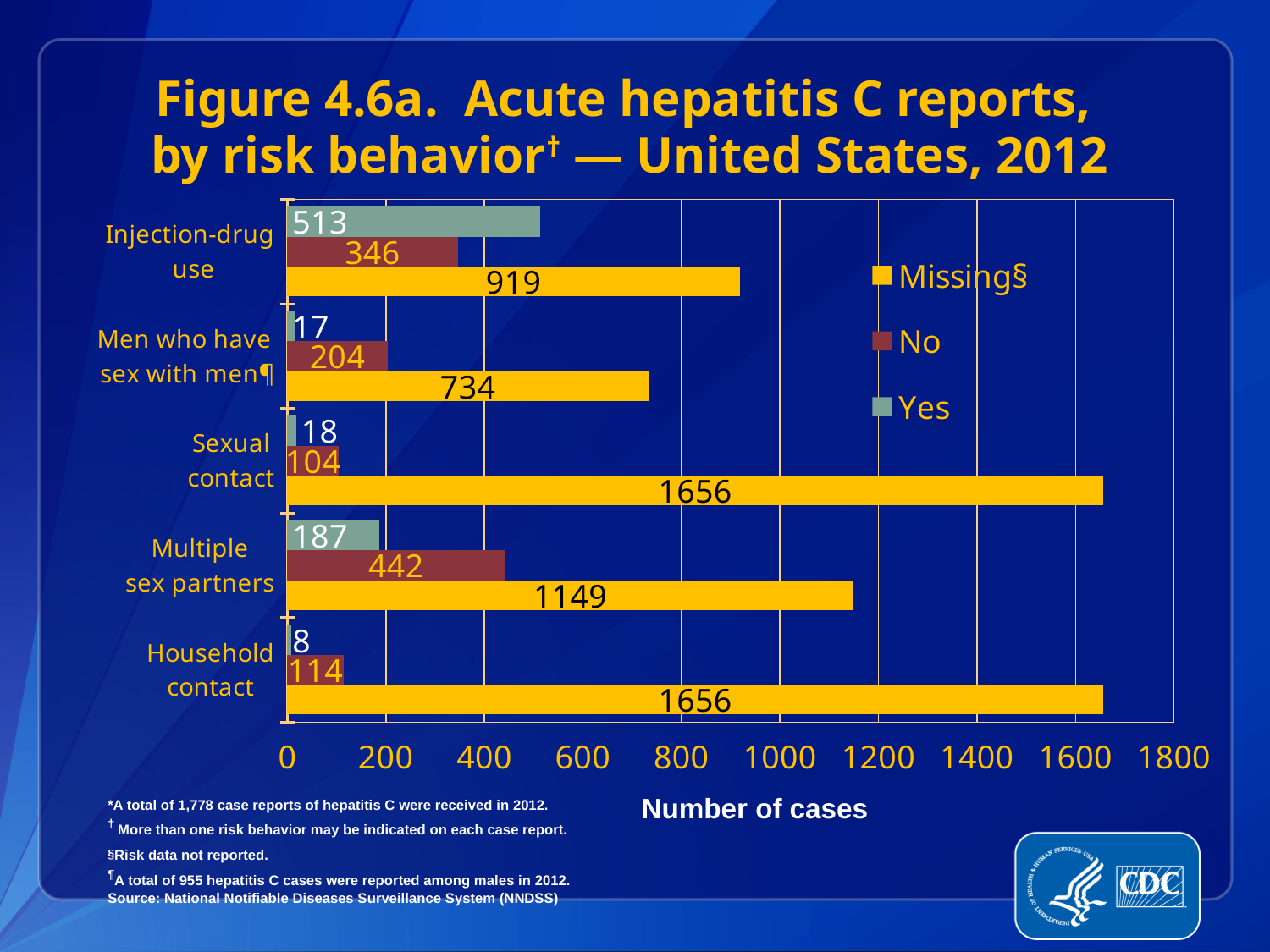
Is the Missing value for Sexual contact greater or less than 1600? greater What is the number of cases for Injection-drug use in the Yes series? 513 What kind of chart is shown on the slide? Bar chart How many risk behavior categories are shown on the chart? 5 Which risk behavior has the highest Yes value? Injection-drug use How many series does the legend list? 3 What is the difference between the No values for Multiple sex partners and Injection-drug use? 96 What is the number of cases for Multiple sex partners in the No series? 442 Which is larger, the Missing value for Injection-drug use or the Missing value for Multiple sex partners? Multiple sex partners Which risk behavior has the lowest Yes value? Household contact What is the label of the x axis? Number of cases What is the Missing value for Men who have sex with men? 734